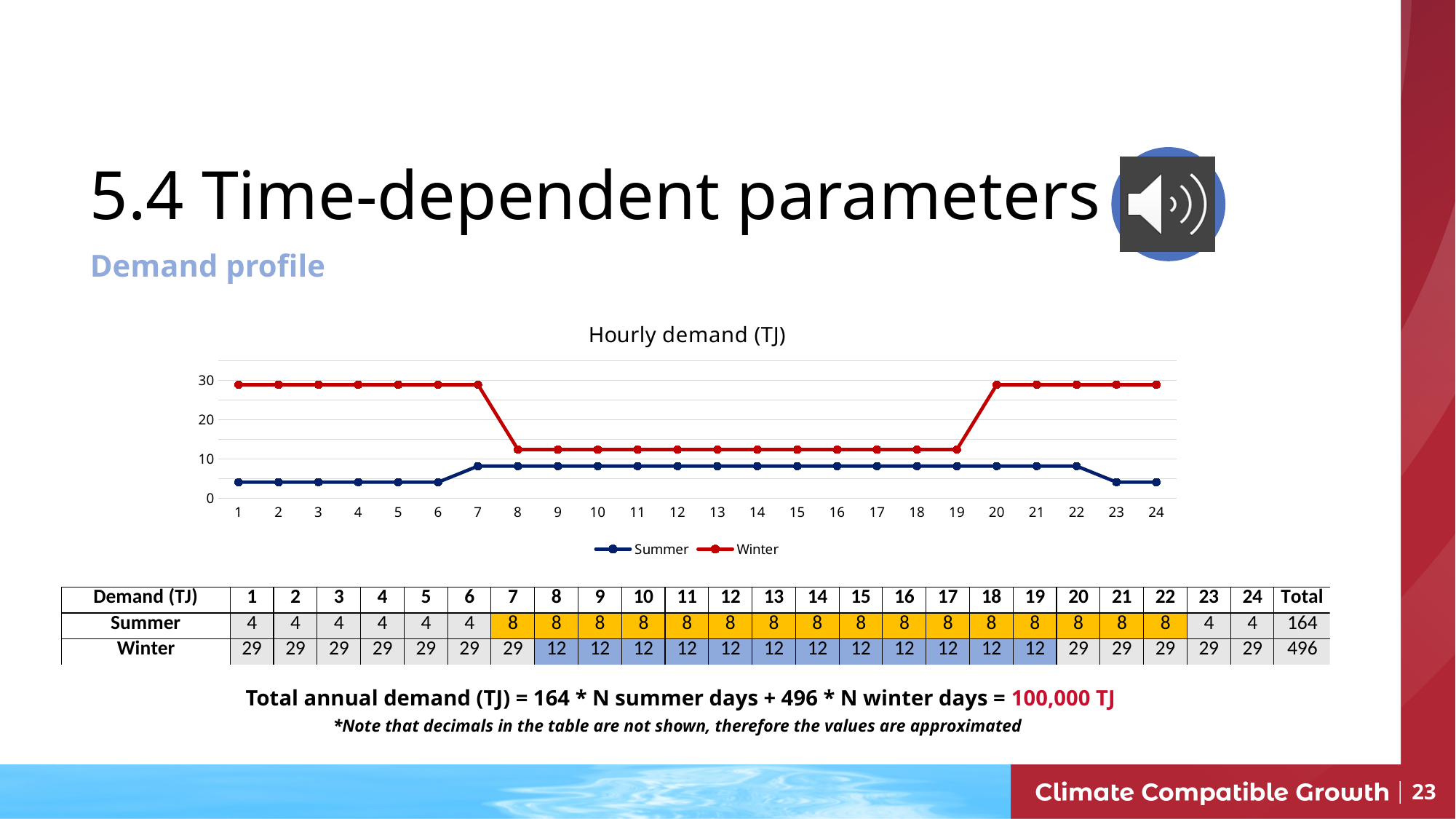
Is the Summer value at hour 2 greater or less than 10? less Does the Winter line rise or fall between hour 7 and hour 8? Falls Is the Winter value at hour 10 greater or less than 20? less At hour 12, which series has the higher value, Summer or Winter? Winter What kind of chart is shown on the slide? Line chart What is the title of the chart? Hourly demand (TJ) Is the Winter value at hour 3 greater or less than 20? greater What colour is the Winter line in the chart? Red Does the Summer line rise or fall between hour 6 and hour 7? Rises How many series does the chart legend list? 2 How many hours are plotted along the x axis of the chart? 24